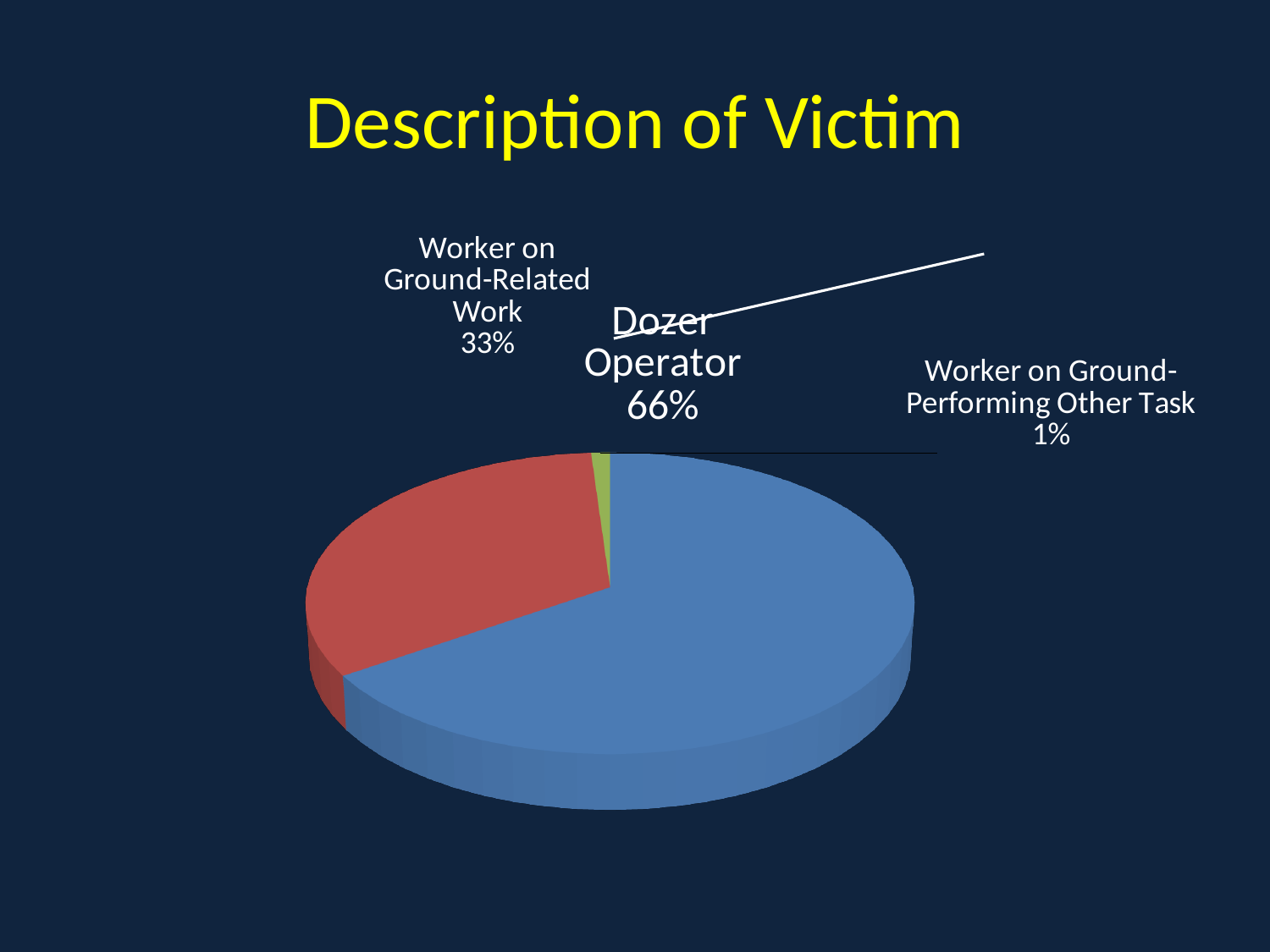
What share of the pie does Worker on Ground-Related Work represent? 33% What is the combined share of Worker on Ground-Related Work and Worker on Ground-Performing Other Task? 34% Which category has the largest share of the pie? Dozer Operator Which category has the smallest share of the pie? Worker on Ground-Performing Other Task Which is larger, the share for Worker on Ground-Related Work or the share for Worker on Ground-Performing Other Task? Worker on Ground-Related Work What share of the pie does Dozer Operator represent? 66% What share of the pie does Worker on Ground-Performing Other Task represent? 1% What is the difference in percentage points between Dozer Operator and Worker on Ground-Related Work? 33 What is the title of the slide? Description of Victim How many categories are shown in the pie chart? 3 What kind of chart is shown on the slide? Pie chart What colour is the Dozer Operator slice? Blue